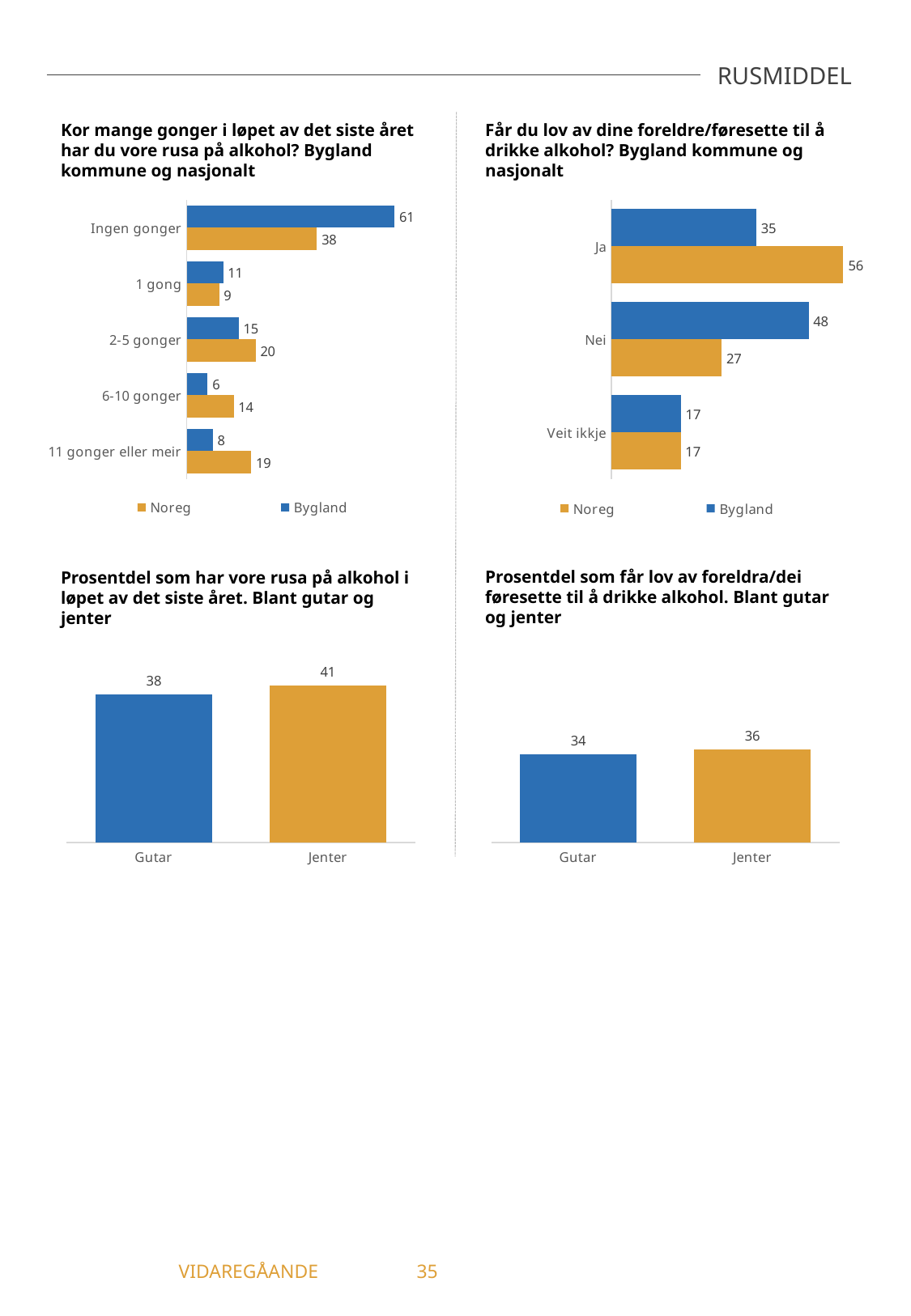
In the bottom-left chart (Prosentdel som har vore rusa på alkohol i løpet av det siste året), what is the difference between Jenter and Gutar? 3 In the bottom-right chart (Prosentdel som får lov av foreldra/dei føresette til å drikke alkohol), what is the value for Gutar? 34 In the top-left chart (Kor mange gonger i løpet av det siste året har du vore rusa på alkohol?), what is the value for Noreg for '11 gonger eller meir'? 19 In the bottom-left chart (Prosentdel som har vore rusa på alkohol i løpet av det siste året), what is the value for Jenter? 41 In the top-right chart (Får du lov av dine foreldre/føresette til å drikke alkohol?), which is larger for 'Nei': Noreg or Bygland? Bygland In the top-right chart (Får du lov av dine foreldre/føresette til å drikke alkohol?), how many series does the legend list? 2 In the top-left chart (Kor mange gonger i løpet av det siste året har du vore rusa på alkohol?), what is the value for Bygland for 'Ingen gonger'? 61 In the top-right chart (Får du lov av dine foreldre/føresette til å drikke alkohol?), which category has the highest value for Bygland? Nei In the top-right chart (Får du lov av dine foreldre/føresette til å drikke alkohol?), what is the value for Noreg for 'Ja'? 56 What kind of chart is the bottom-right chart (Prosentdel som får lov av foreldra/dei føresette til å drikke alkohol)? Bar chart In the top-left chart (Kor mange gonger i løpet av det siste året har du vore rusa på alkohol?), what is the difference between Noreg and Bygland for '6-10 gonger'? 8 In the top-left chart (Kor mange gonger i løpet av det siste året har du vore rusa på alkohol?), how many categories are shown? 5